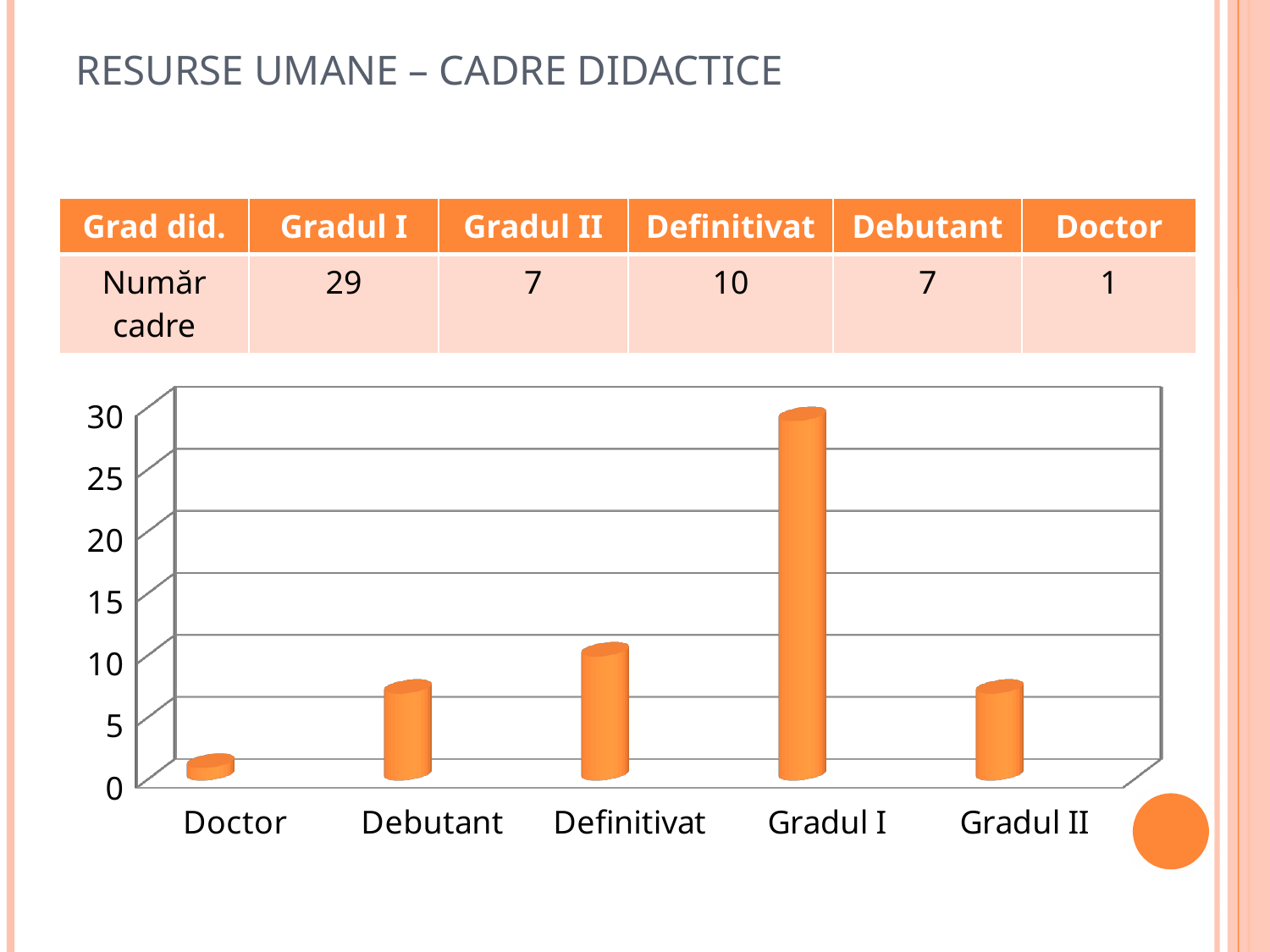
According to the slide, how many cadre are Doctor? 1 What is the difference between the number of cadre in Gradul I and the number that are Definitivat? 19 Is the value for Gradul I greater or less than 25? greater How many categories are shown on the x axis of the chart? 5 According to the slide, how many cadre are in Gradul I? 29 What colour are the bars in the chart? orange Which category has the shortest bar in the chart? Doctor Which is larger in the chart, the bar for Definitivat or the bar for Debutant? Definitivat What kind of chart is shown on the slide? bar chart According to the slide, how many cadre are Definitivat? 10 Which category has the tallest bar in the chart? Gradul I Is the value for Doctor greater or less than 5? less